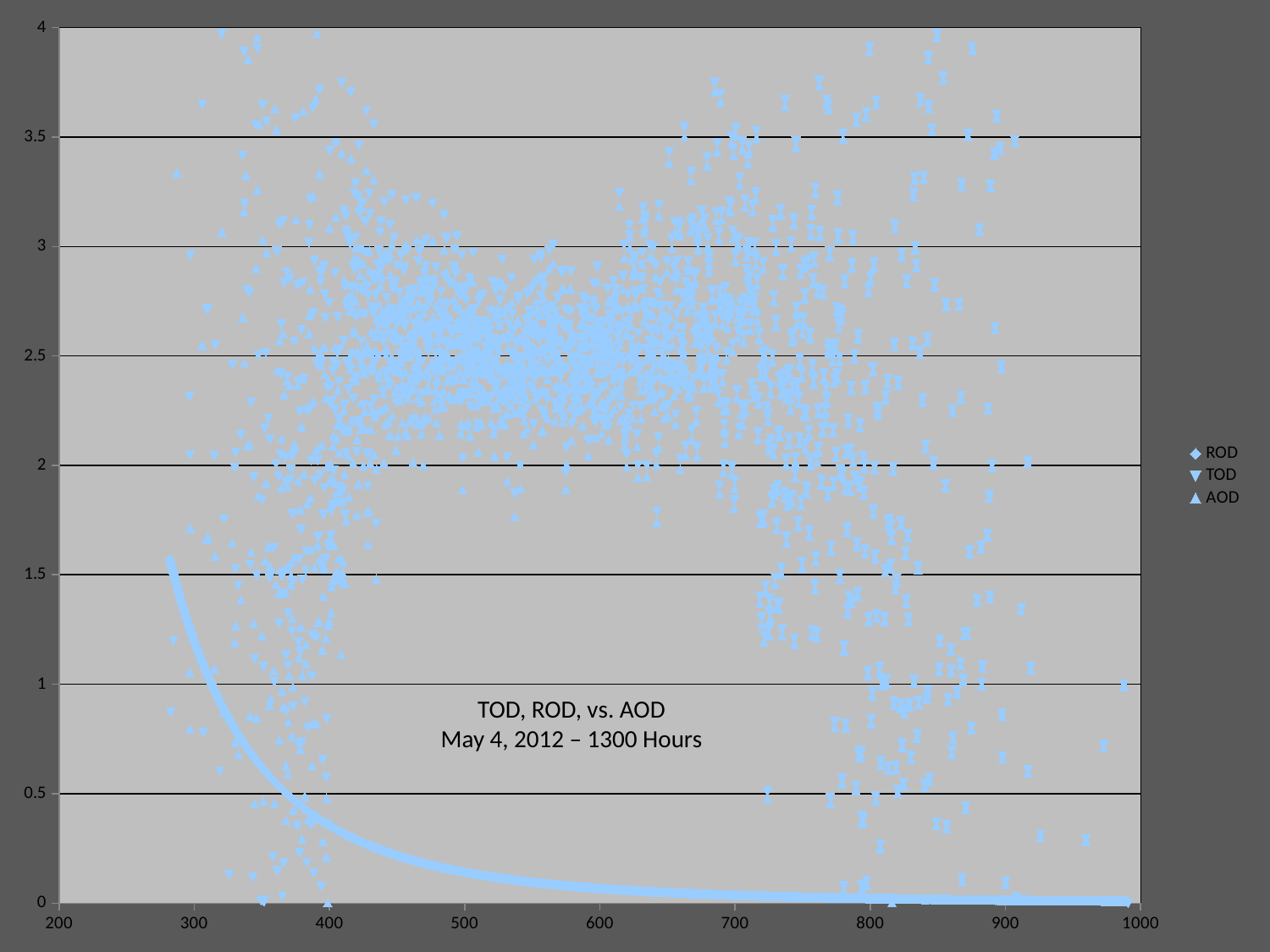
What is the lowest value shown on the x-axis? 200 Does the ROD series rise or fall as the x-axis value increases? Fall Is the ROD value at x = 900 greater or less than 0.5? less What is the highest value shown on the y-axis? 4 How many series does the legend list? 3 Is the ROD value at x = 600 greater or less than 0.5? less What kind of chart is shown on the slide? Scatter chart What is the title of the chart? TOD, ROD, vs. AOD May 4, 2012 – 1300 Hours Is the ROD value at x = 400 greater or less than 0.5? less